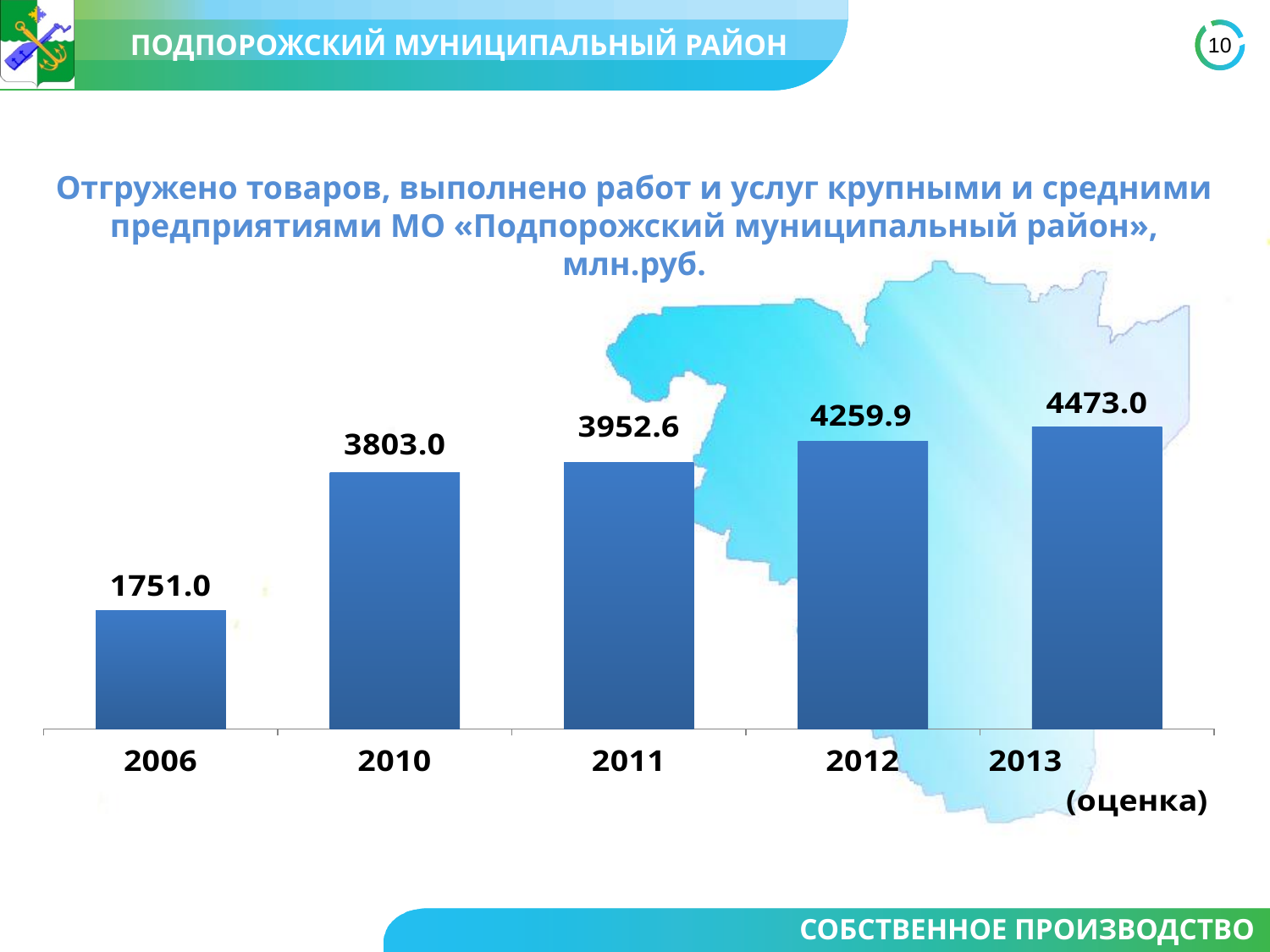
What is the value for 2006? 1751.0 What is the value for 2012? 4259.9 Which year has the lowest value? 2006 What is the value for 2010? 3803.0 What is the difference between the values for 2010 and 2006? 2052.0 What is the value for 2011? 3952.6 Which year has the highest value? 2013 How many years are shown on the x axis? 5 Which is larger, the value for 2011 or the value for 2010? 2011 What is the value for 2013 (оценка)? 4473.0 What is the difference between the values for 2013 and 2012? 213.1 What kind of chart is shown on the slide? bar chart